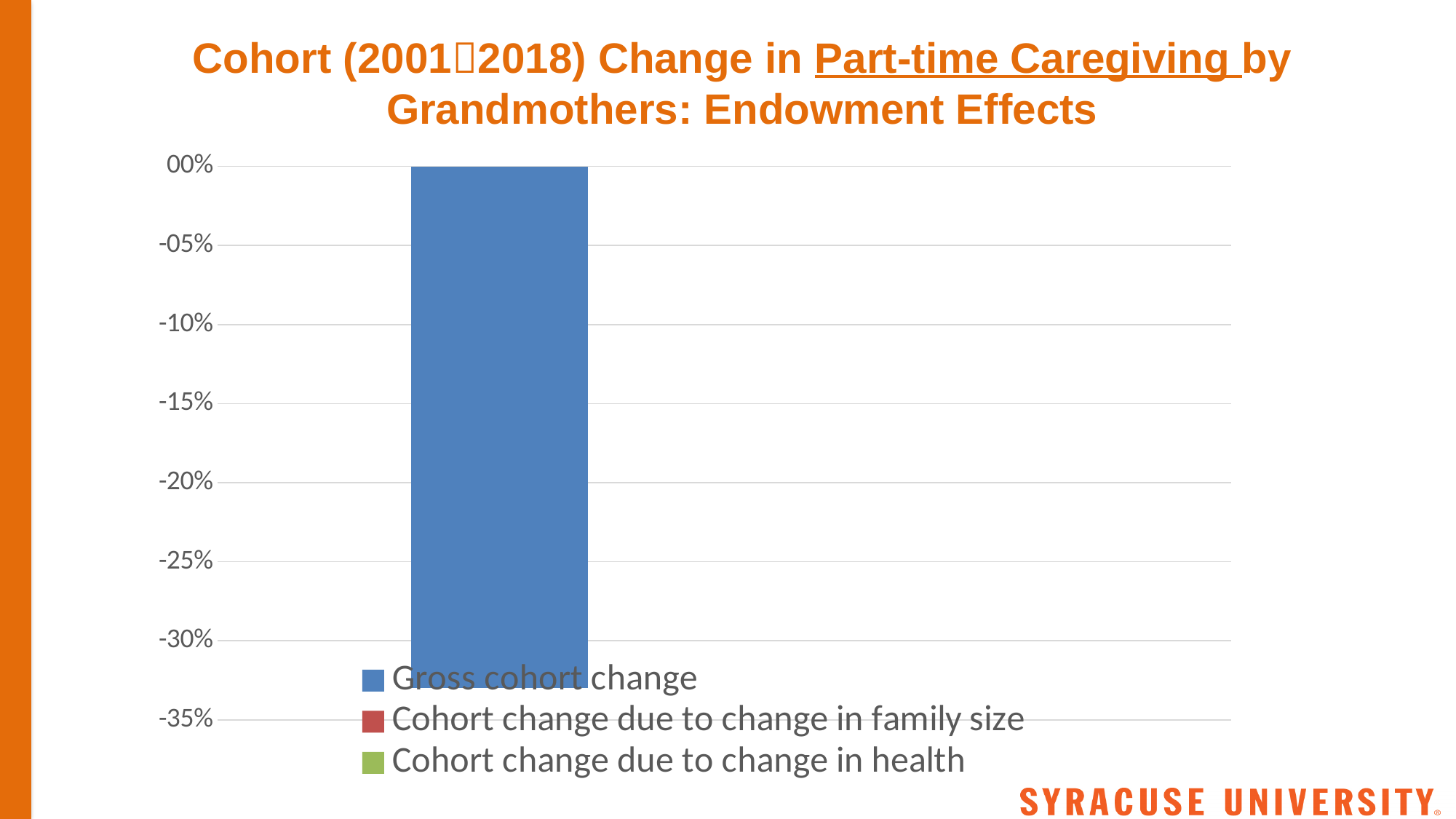
What is the title of the chart? Cohort (2001–2018) Change in Part-time Caregiving by Grandmothers: Endowment Effects How many series does the legend list? 3 Is the value for Gross cohort change greater or less than -30%? less Is the value for Gross cohort change greater or less than -20%? less What colour is the bar for Gross cohort change? blue What kind of chart is shown on the slide? bar chart Is the value for Gross cohort change greater or less than -35%? greater